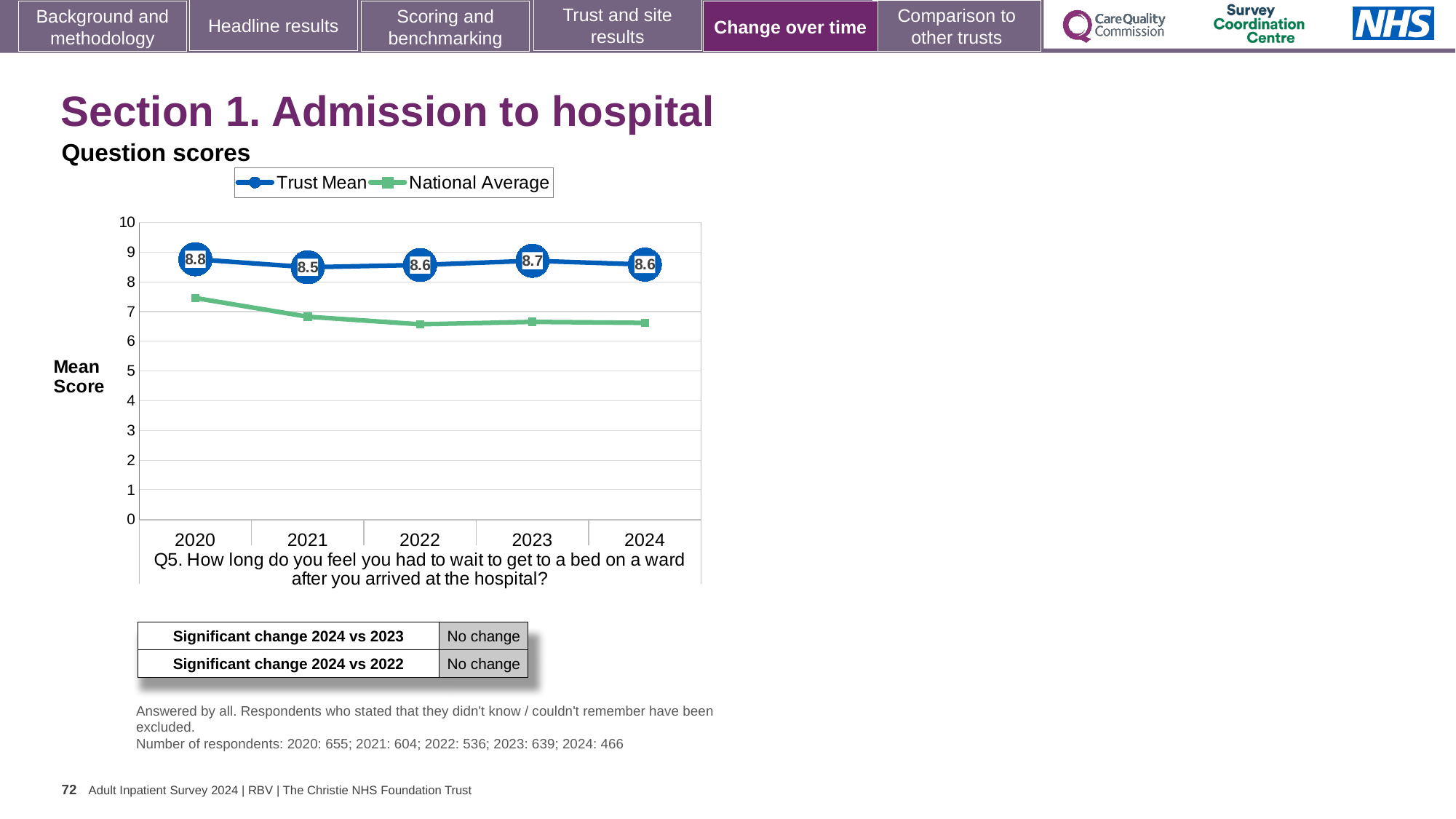
How many series does the legend list? 2 Is the National Average value for 2022 greater or less than 7? less What is the Trust Mean score for 2024? 8.6 How many years are plotted on the x axis? 5 In which year is the Trust Mean highest? 2020 Is the National Average value for 2020 greater or less than 7? greater In which year is the Trust Mean lowest? 2021 What kind of chart is shown on the slide? Line chart Which is larger, the Trust Mean in 2023 or the Trust Mean in 2021? 2023 What is the Trust Mean score for 2020? 8.8 What is the Trust Mean score for 2023? 8.7 What is the difference between the Trust Mean in 2020 and in 2021? 0.3